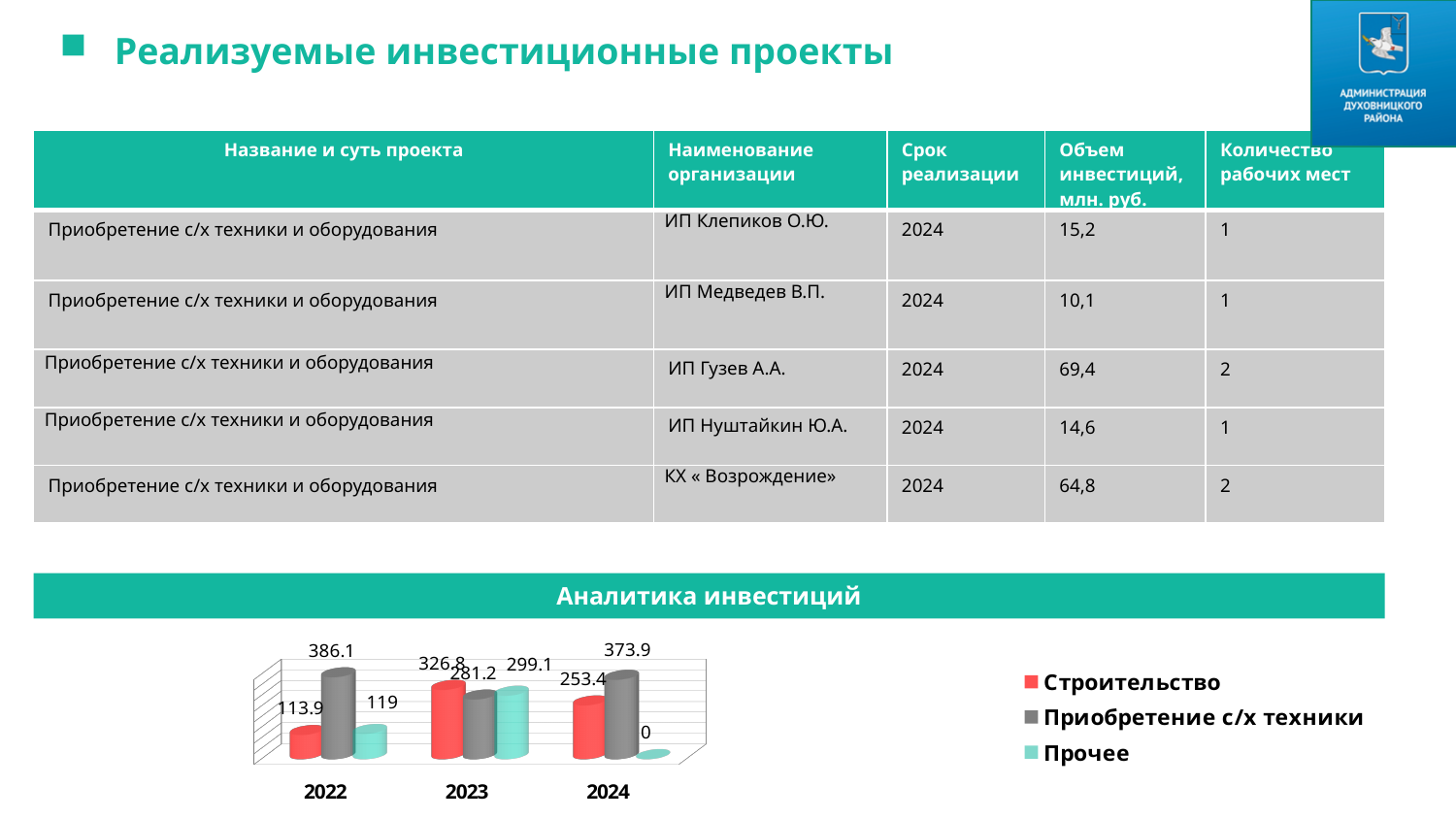
What is the value for Приобретение с/х техники in 2024? 373.9 What is the value for Строительство in 2023? 326.8 What is the difference between Приобретение с/х техники and Строительство in 2022? 272.2 In which year is the value for Приобретение с/х техники lowest? 2023 What kind of chart is shown under the heading Аналитика инвестиций? Bar chart What is the value for Прочее in 2024? 0 Which is larger in 2023: Строительство or Прочее? Строительство How many years are shown on the x axis of the chart? 3 In which year is the value for Строительство highest? 2023 What is the value for Строительство in 2022? 113.9 What is the value for Приобретение с/х техники in 2022? 386.1 How many series does the chart legend list? 3